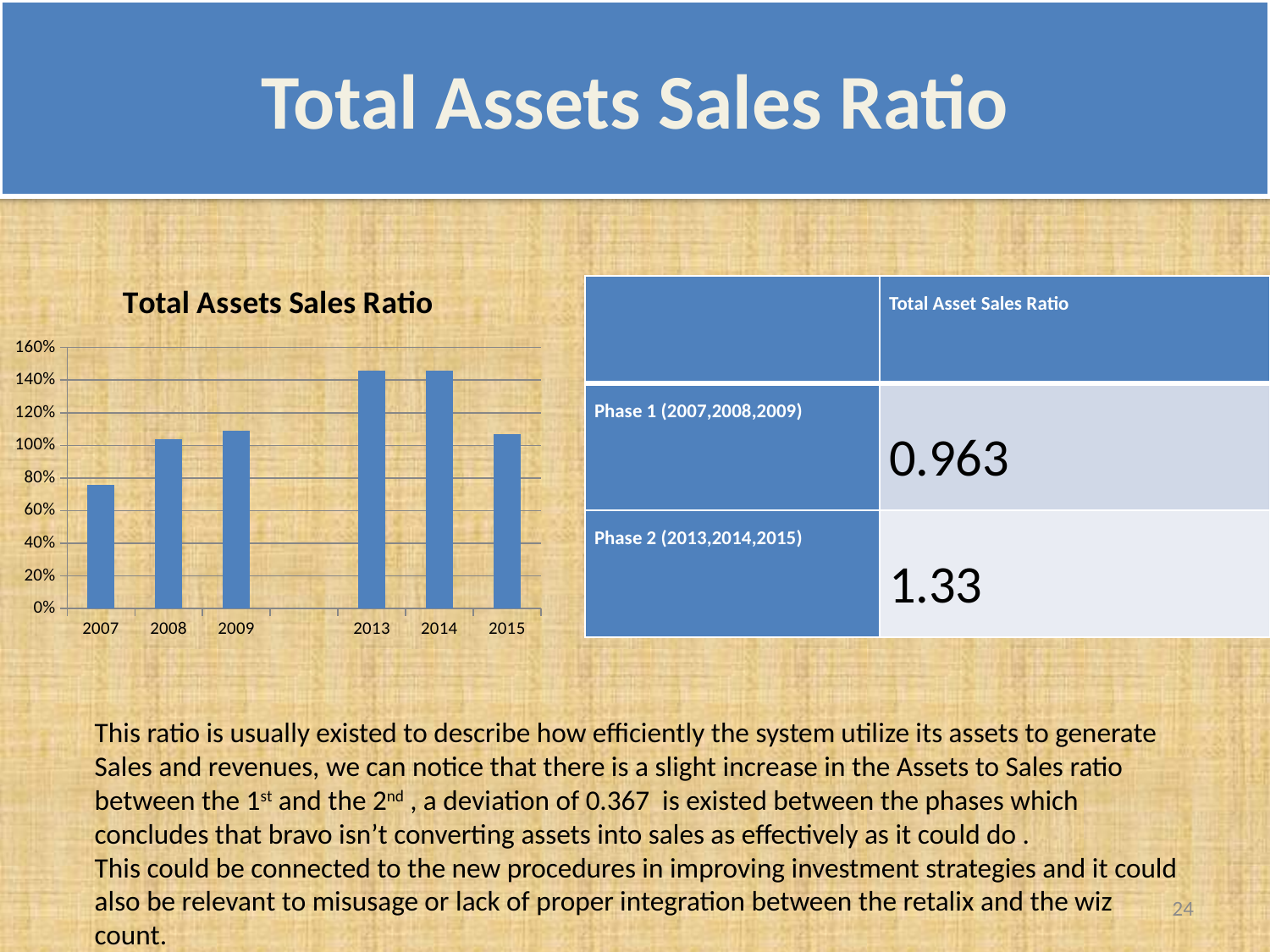
How many years are plotted on the chart? 6 Is the value for 2013 greater or less than 140%? greater Is the value for 2007 greater or less than 80%? less Is the value for 2015 greater or less than 120%? less Which is larger, the value for 2007 or the value for 2008? 2008 What kind of chart is shown on the slide? bar chart Which is larger, the value for 2013 or the value for 2015? 2013 What is the title of the chart? Total Assets Sales Ratio Do the values rise or fall from 2007 to 2009? rise Which year has the lowest Total Assets Sales Ratio? 2007